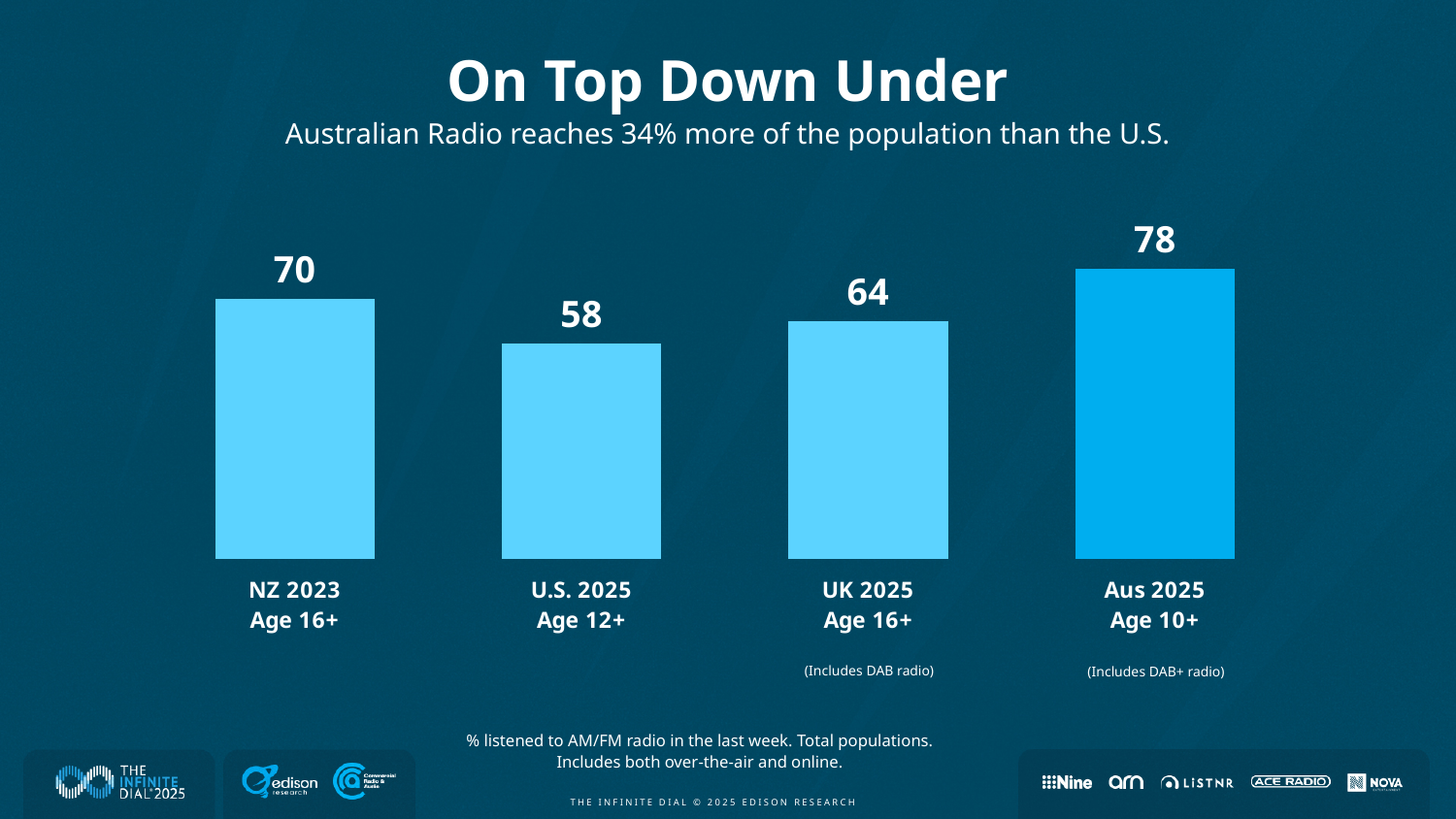
What kind of chart is shown on the slide? Bar chart What is the difference between the values for Aus 2025 and U.S. 2025? 20 What is the value for UK 2025 (Age 16+)? 64 What is the value for NZ 2023 (Age 16+)? 70 How many categories are shown in the chart? 4 Which category has the highest value? Aus 2025 What is the difference between the values for NZ 2023 and UK 2025? 6 What is the value for Aus 2025 (Age 10+)? 78 Which category has the lowest value? U.S. 2025 Which is larger, the value for NZ 2023 or the value for UK 2025? NZ 2023 What is the value for U.S. 2025 (Age 12+)? 58 What is the title of the slide? On Top Down Under